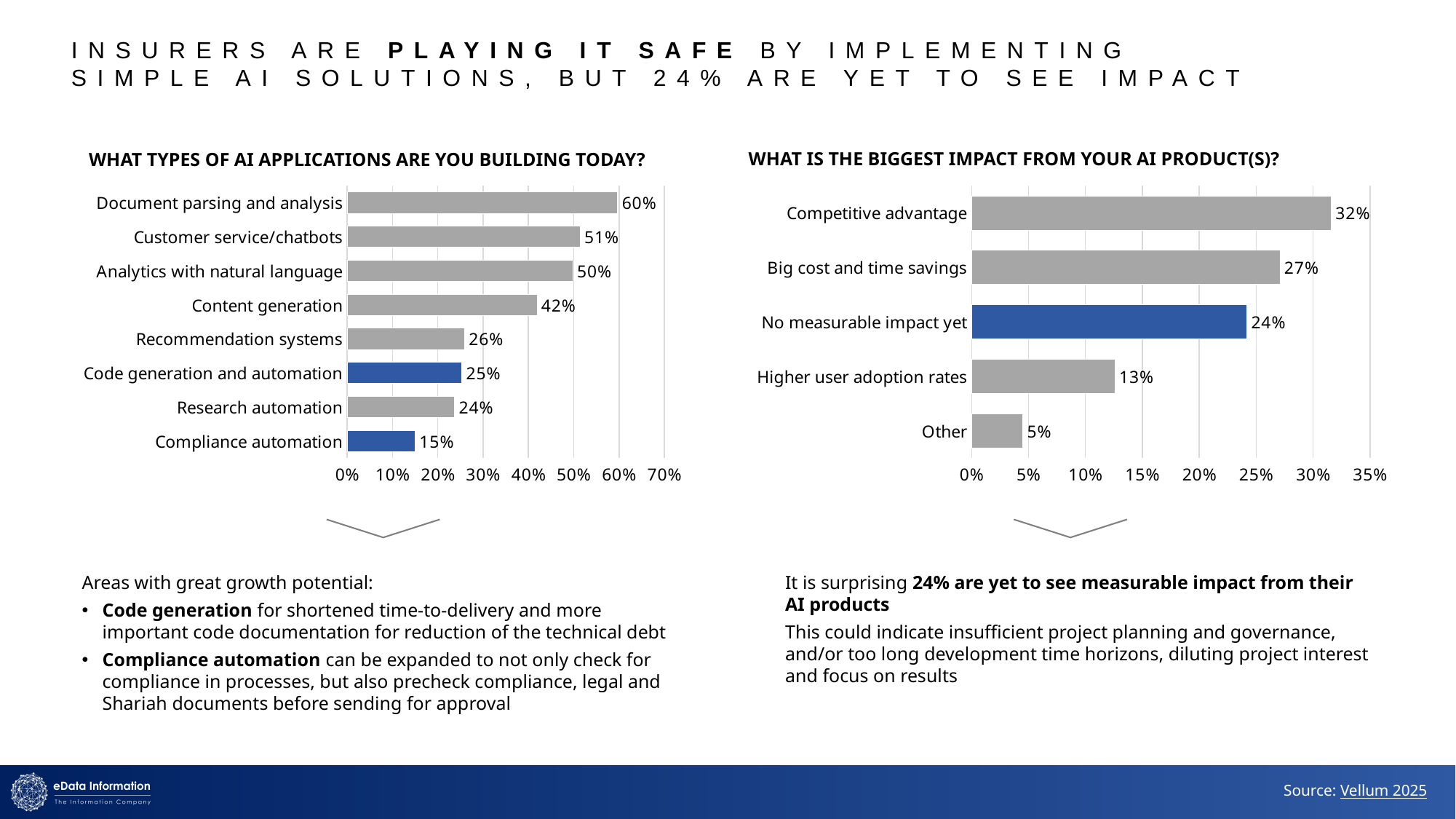
In the chart 'What is the biggest impact from your AI product(s)?', how many categories are shown? 5 In the chart 'What types of AI applications are you building today?', how many categories are shown? 8 In the chart 'What is the biggest impact from your AI product(s)?', what is the difference between Competitive advantage and Big cost and time savings? 5% In the chart 'What types of AI applications are you building today?', which category has the lowest value? Compliance automation In the chart 'What is the biggest impact from your AI product(s)?', which category has the highest value? Competitive advantage In the chart 'What types of AI applications are you building today?', which is larger: Customer service/chatbots or Analytics with natural language? Customer service/chatbots In the chart 'What is the biggest impact from your AI product(s)?', what is the value for No measurable impact yet? 24% In the chart 'What types of AI applications are you building today?', what is the value for Document parsing and analysis? 60% In the chart 'What types of AI applications are you building today?', what is the value for Compliance automation? 15% In the chart 'What types of AI applications are you building today?', what is the difference between Content generation and Code generation and automation? 17% In the chart 'What is the biggest impact from your AI product(s)?', which bar is coloured blue? No measurable impact yet What type of chart is 'What is the biggest impact from your AI product(s)?' Bar chart